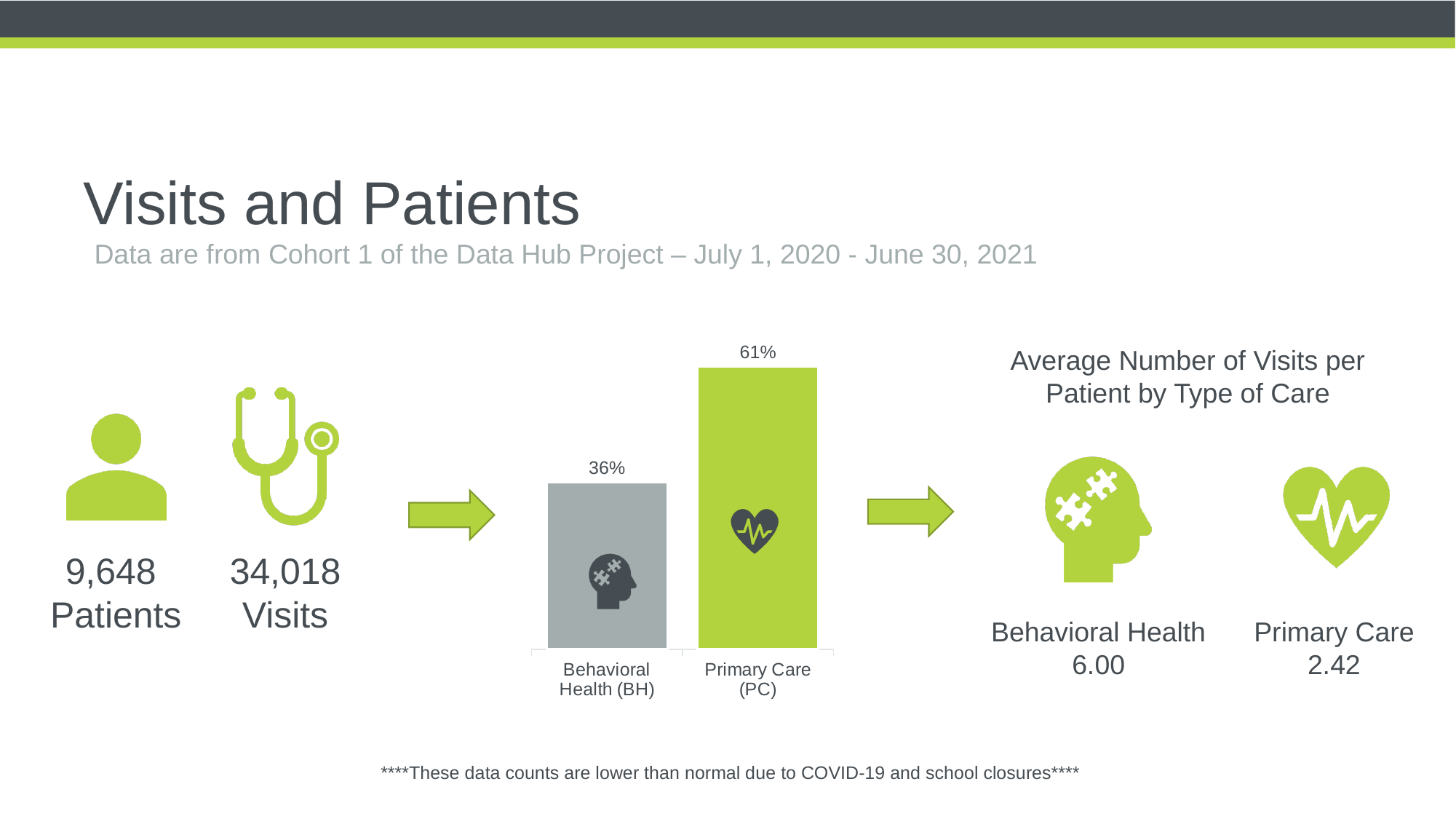
What is the value shown for Primary Care (PC) in the bar chart? 61% Which category has the highest value in the bar chart? Primary Care (PC) What is the difference between the Primary Care (PC) and Behavioral Health (BH) values in the bar chart? 25% What kind of chart is shown in the middle of the slide? bar chart What colour is the Behavioral Health (BH) bar in the bar chart? grey What is the value shown for Behavioral Health (BH) in the bar chart? 36% Which category has the lowest value in the bar chart? Behavioral Health (BH) What colour is the Primary Care (PC) bar in the bar chart? green Is the value for Primary Care (PC) larger or smaller than the value for Behavioral Health (BH) in the bar chart? larger How many categories are shown in the bar chart? 2